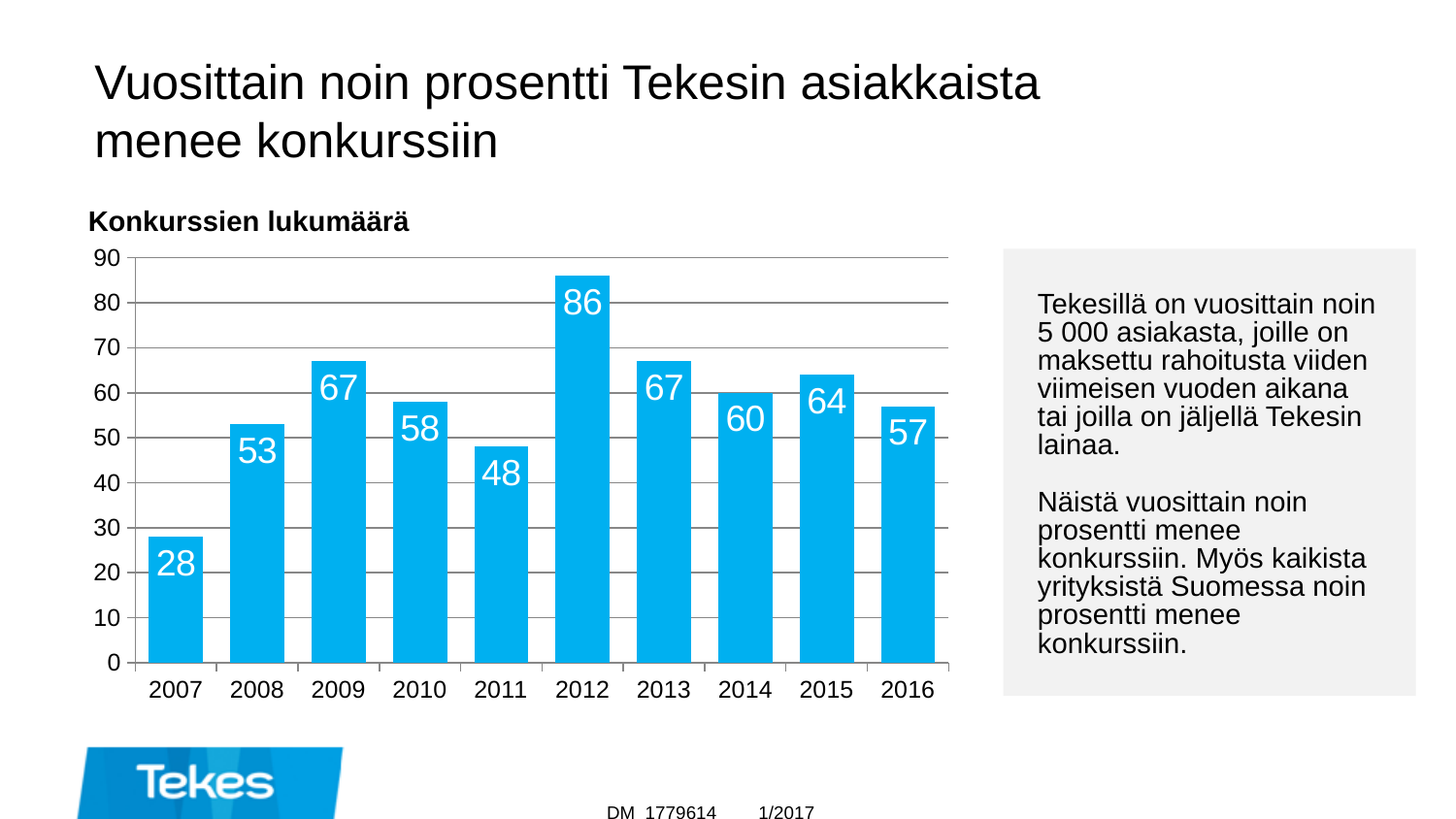
What is the difference between the values for 2012 and 2011? 38 How many years are shown on the x axis? 10 What is the number of bankruptcies shown for 2012? 86 What value is shown for 2016? 57 Which is larger, the value for 2010 or the value for 2011? 2010 Is the value for 2013 greater or less than 60? greater Which year has the highest number of bankruptcies? 2012 What is the difference between the values for 2015 and 2014? 4 Which year has the lowest number of bankruptcies? 2007 What value is shown for 2007? 28 What kind of chart is shown on the slide? bar chart What is the title of the chart? Konkurssien lukumäärä